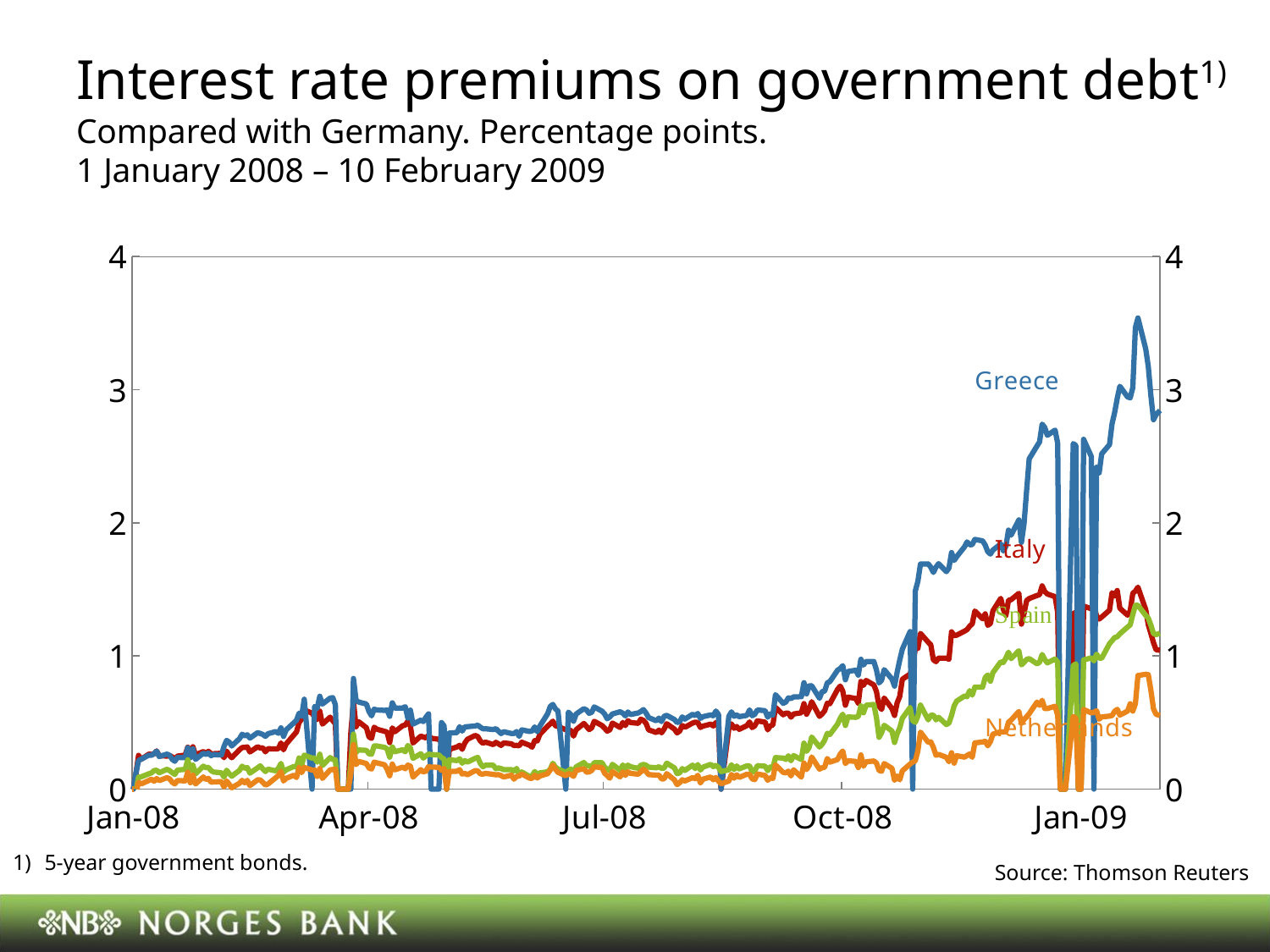
Which country has the highest interest rate premium at the end of the period shown? Greece How many countries' series are plotted on the chart? 4 Do the interest rate premiums generally rise or fall from January 2008 to early 2009? Rise What is the title of the chart? Interest rate premiums on government debt Is the peak value for the Netherlands greater or less than 1? less Which is larger in January 2009, the premium for Greece or the premium for the Netherlands? Greece What is the source given for the chart data? Thomson Reuters Which country has the lowest interest rate premium over most of the period shown? Netherlands Is the peak value for Italy greater or less than 2? less What kind of chart is shown on the slide? Line chart Is the peak value for Greece greater or less than 3? greater